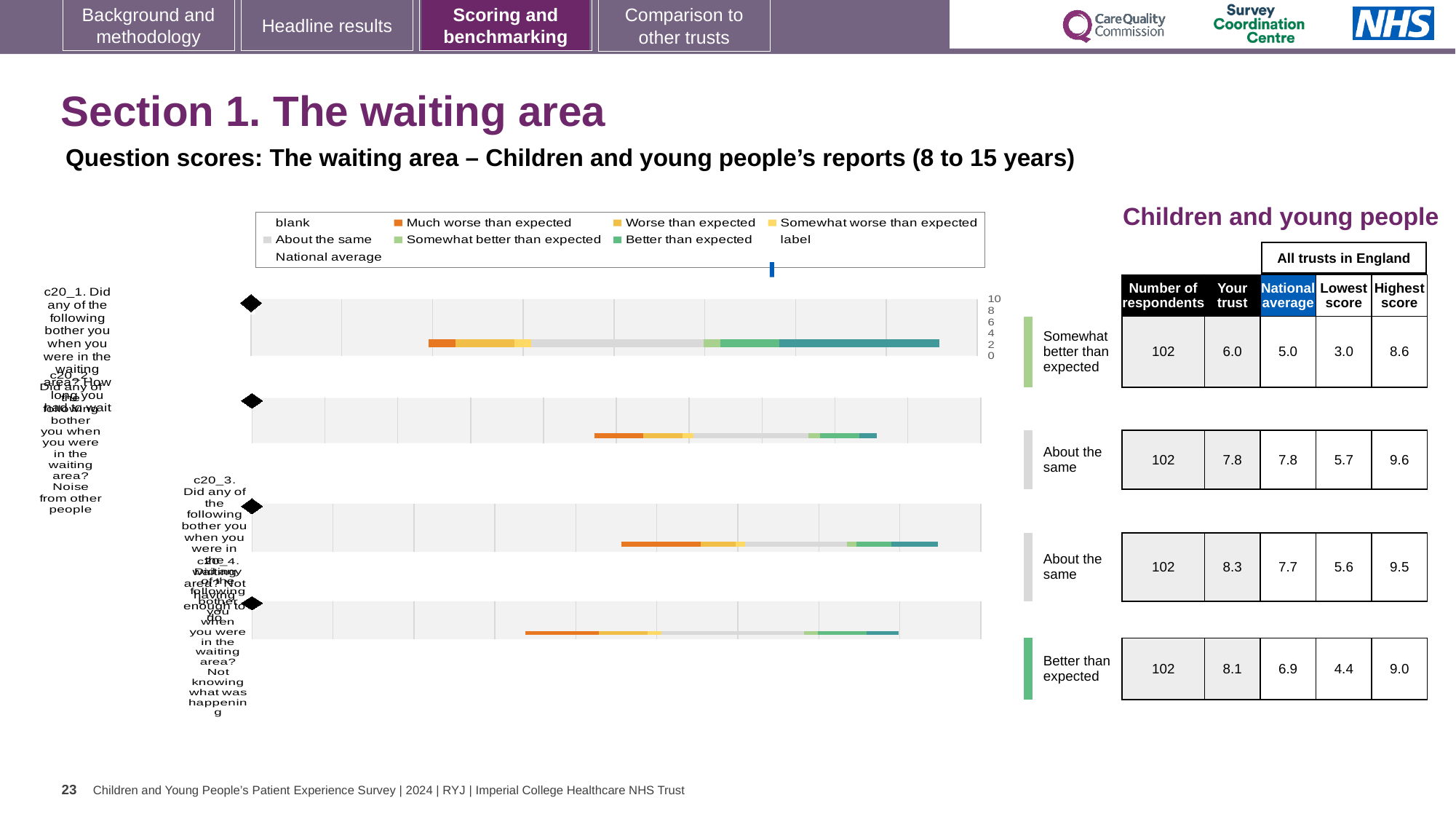
Which legend entry is shown in light grey? About the same In the table beside the chart, how many respondents are listed for each row? 102 How many entries does the chart legend list? 9 In the table beside the chart, what is the national average for the first row (Somewhat better than expected)? 5.0 What colour does the legend use for 'Much worse than expected'? orange In the table beside the chart, which row has the highest 'Your trust' score? the third row (8.3) In the table beside the chart, which is larger for the third row: the 'Your trust' score or the national average? Your trust What kind of chart is shown on the slide? bar chart In the table beside the chart, what is the lowest value in the 'Lowest score' column? 3.0 How many horizontal bars (question rows) does the chart show? 4 In the table beside the chart, what is the 'Your trust' score for the first row (Somewhat better than expected)? 6.0 In the table beside the chart, what is the difference between the 'Your trust' score (8.3) and the national average (7.7) in the third row? 0.6